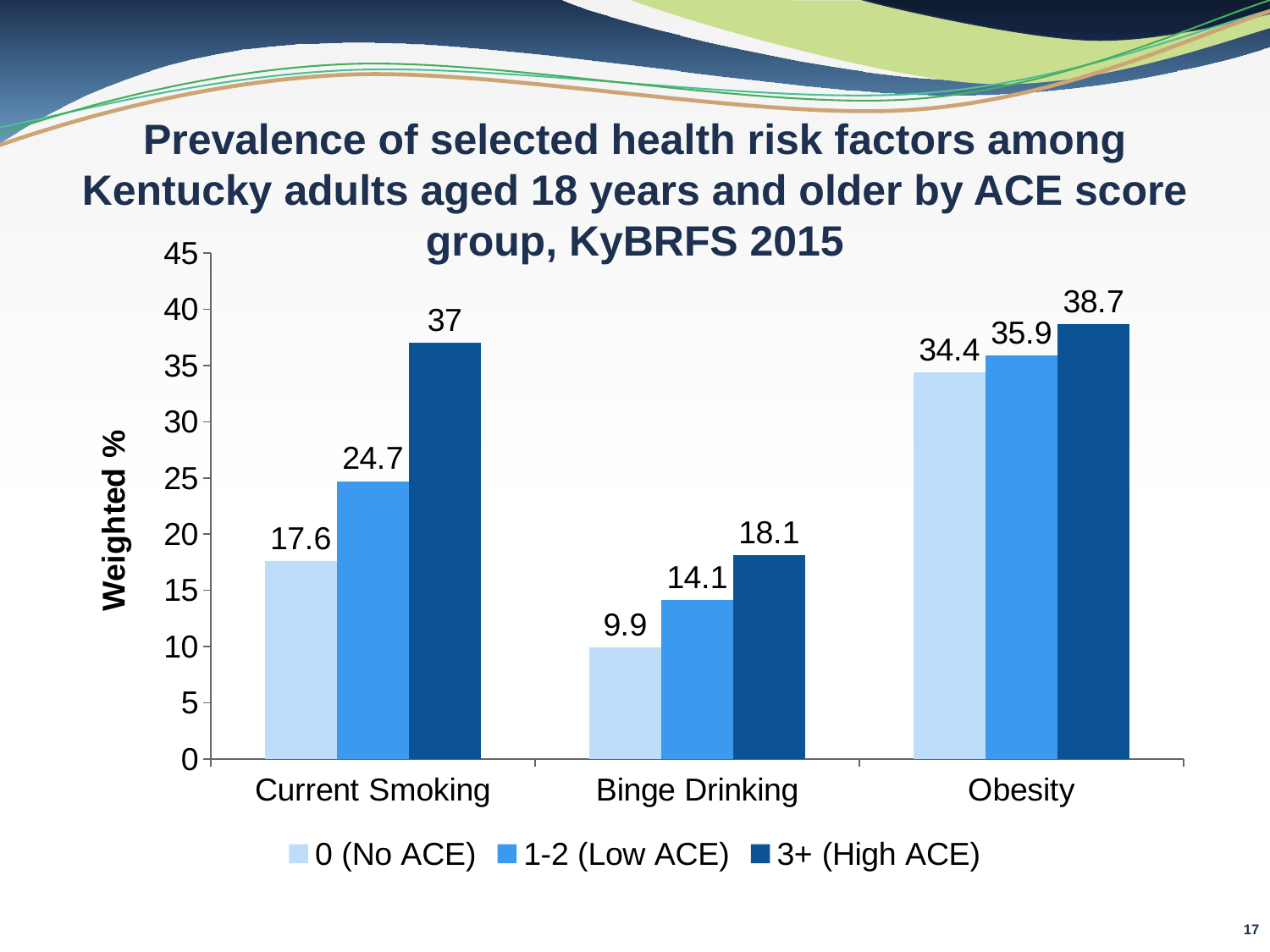
What is the weighted % for Current Smoking in the 3+ (High ACE) group? 37 What is the weighted % for Binge Drinking in the 0 (No ACE) group? 9.9 What type of chart is shown on the slide? Bar chart How many health risk factor categories are shown on the x axis? 3 What is the weighted % for Obesity in the 1-2 (Low ACE) group? 35.9 Is the weighted % for Obesity in the 0 (No ACE) group greater or less than 30? greater How many ACE score groups does the legend list? 3 What is the label of the y axis? Weighted % Which risk factor has the lowest weighted % in the 0 (No ACE) group? Binge Drinking Which is larger for Binge Drinking: the 1-2 (Low ACE) value or the 3+ (High ACE) value? 3+ (High ACE) What is the difference in weighted % for Current Smoking between the 3+ (High ACE) group and the 0 (No ACE) group? 19.4 Which risk factor has the highest weighted % in the 3+ (High ACE) group? Obesity